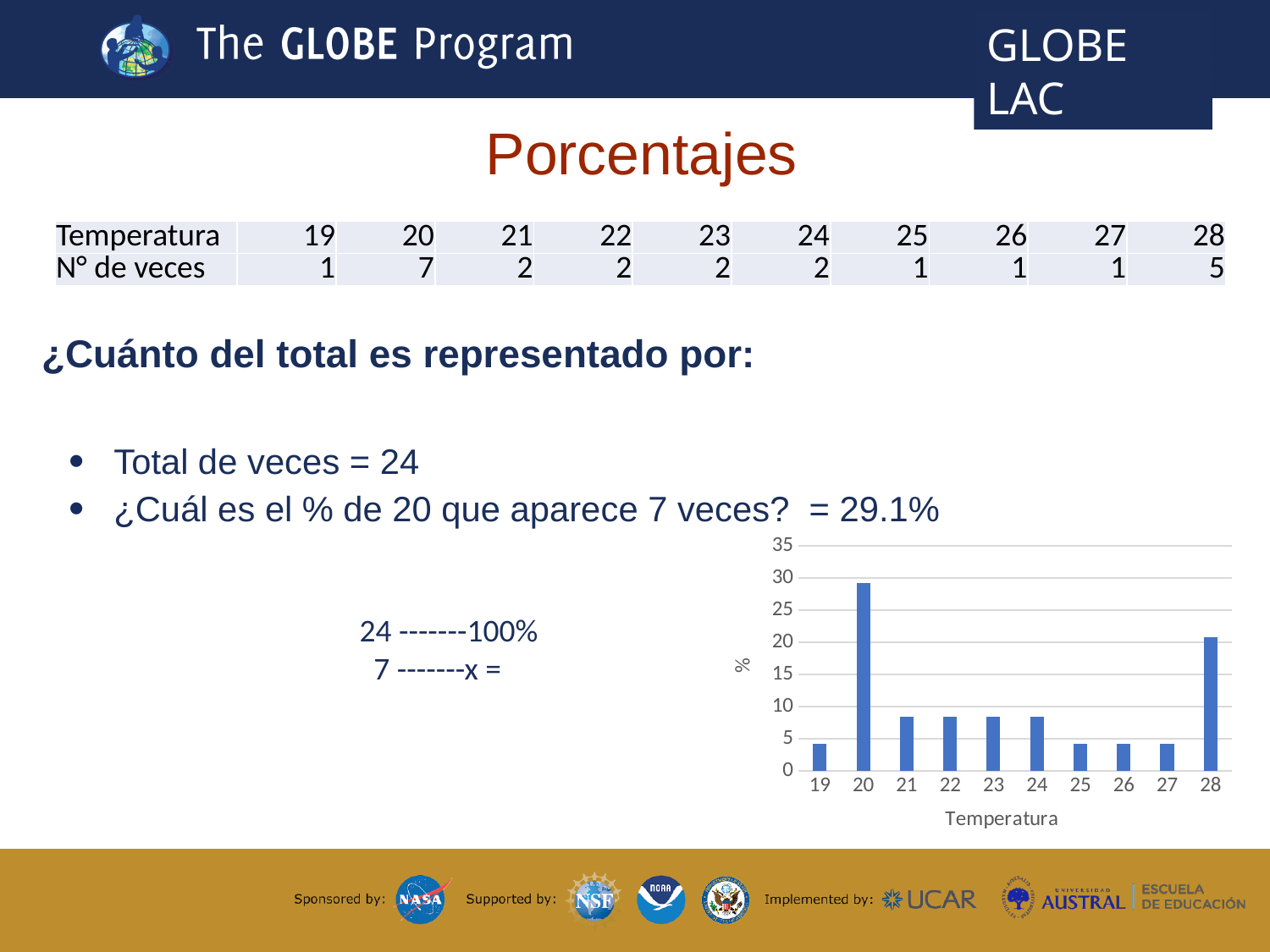
What kind of chart is shown on the slide? bar chart Is the value for temperature 20 greater or less than 25? greater How many temperature categories are plotted on the x axis of the chart? 10 Is the value for temperature 23 greater or less than 10? less What is the label of the x axis of the chart? Temperatura Is the value for temperature 28 greater or less than 25? less Which has the larger bar in the chart, temperature 20 or temperature 28? 20 Which temperature has the highest bar in the chart? 20 Which has the larger bar in the chart, temperature 21 or temperature 26? 21